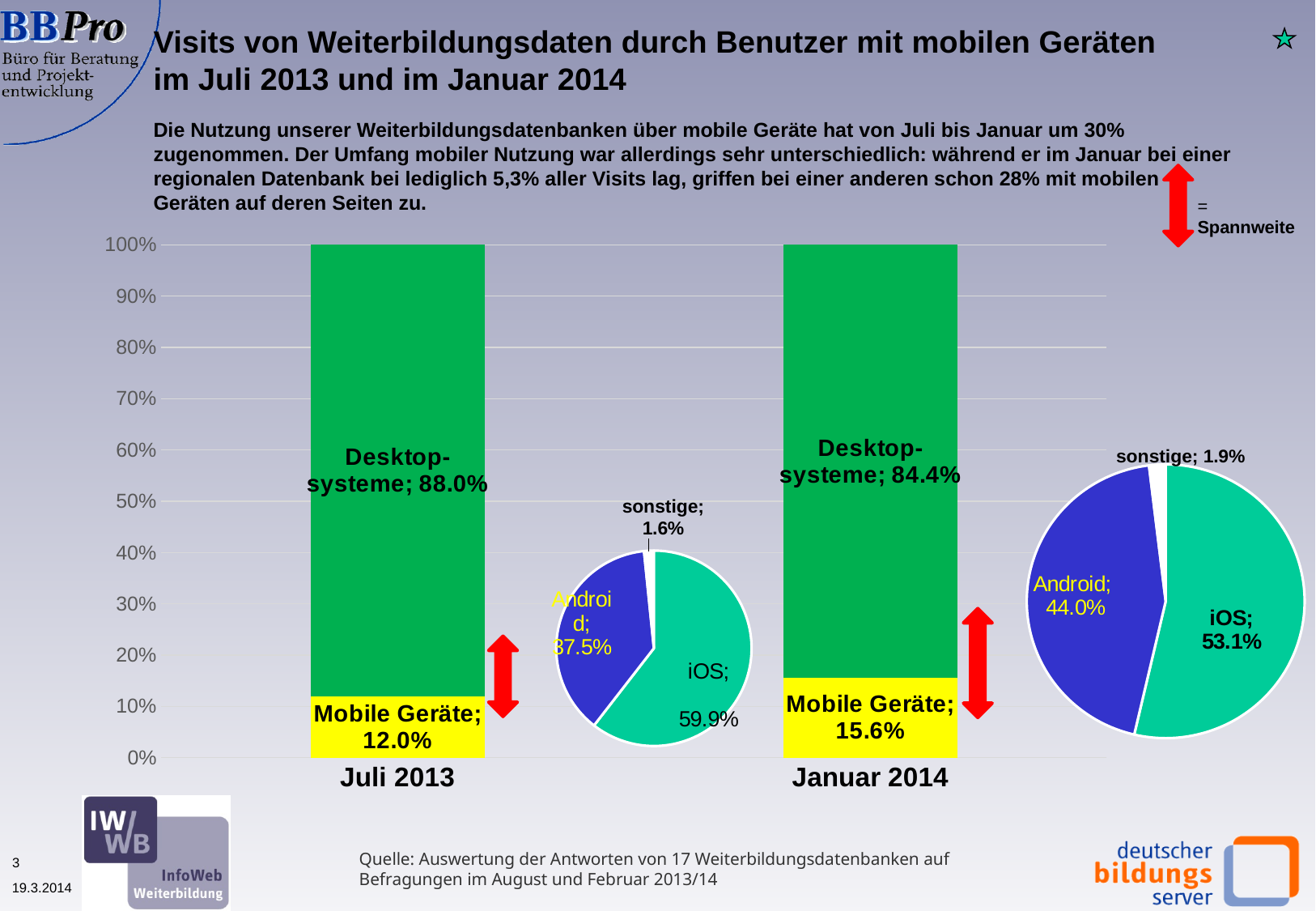
In the stacked bar chart, what is the value for Desktop-systeme in Januar 2014? 84.4% How many slices does the pie chart for Juli 2013 have? 3 In the pie chart for Januar 2014, what is the share for sonstige? 1.9% In the stacked bar chart, what is the value for Mobile Geräte in Juli 2013? 12.0% In the pie chart for Januar 2014, which slice is the largest? iOS In the stacked bar chart, by how many percentage points did the Mobile Geräte share change from Juli 2013 to Januar 2014? 3.6 percentage points In the pie chart for Juli 2013, what is the share for Android? 37.5% In the stacked bar chart, what is the total of the Juli 2013 bar (Desktop-systeme plus Mobile Geräte)? 100.0% In the pie chart for Juli 2013, what is the share for iOS? 59.9% In the stacked bar chart, what is the value for Mobile Geräte in Januar 2014? 15.6% In the stacked bar chart, which period has the larger Desktop-systeme share, Juli 2013 or Januar 2014? Juli 2013 In the pie chart for Januar 2014, what is the difference between the iOS and Android shares? 9.1 percentage points